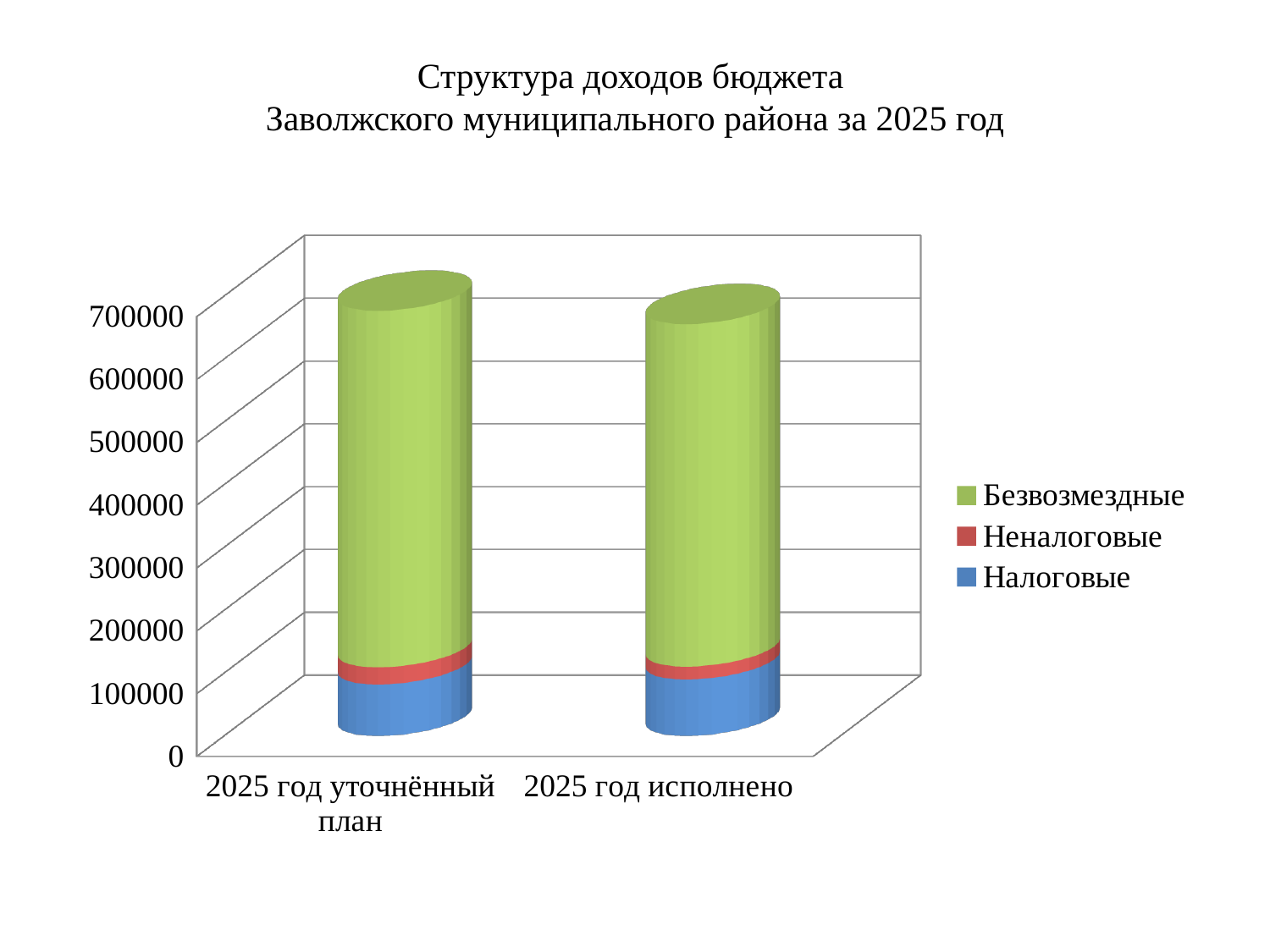
Is the value of Налоговые for 2025 год исполнено greater or less than 300000? less How many series does the chart legend list? 3 Which series makes up the largest part of the bar for 2025 год уточнённый план? Безвозмездные Which series is shown in green in the chart? Безвозмездные What kind of chart is shown on the slide? bar chart What is the title of the chart? Структура доходов бюджета Заволжского муниципального района за 2025 год Which stacked bar has the larger total: 2025 год уточнённый план or 2025 год исполнено? 2025 год уточнённый план Which series makes up the smallest part of the bar for 2025 год исполнено? Неналоговые How many categories are shown on the x axis of the chart? 2 Is the total of the stacked bar for 2025 год уточнённый план greater or less than 400000? greater Is the total of the stacked bar for 2025 год исполнено greater or less than 500000? greater